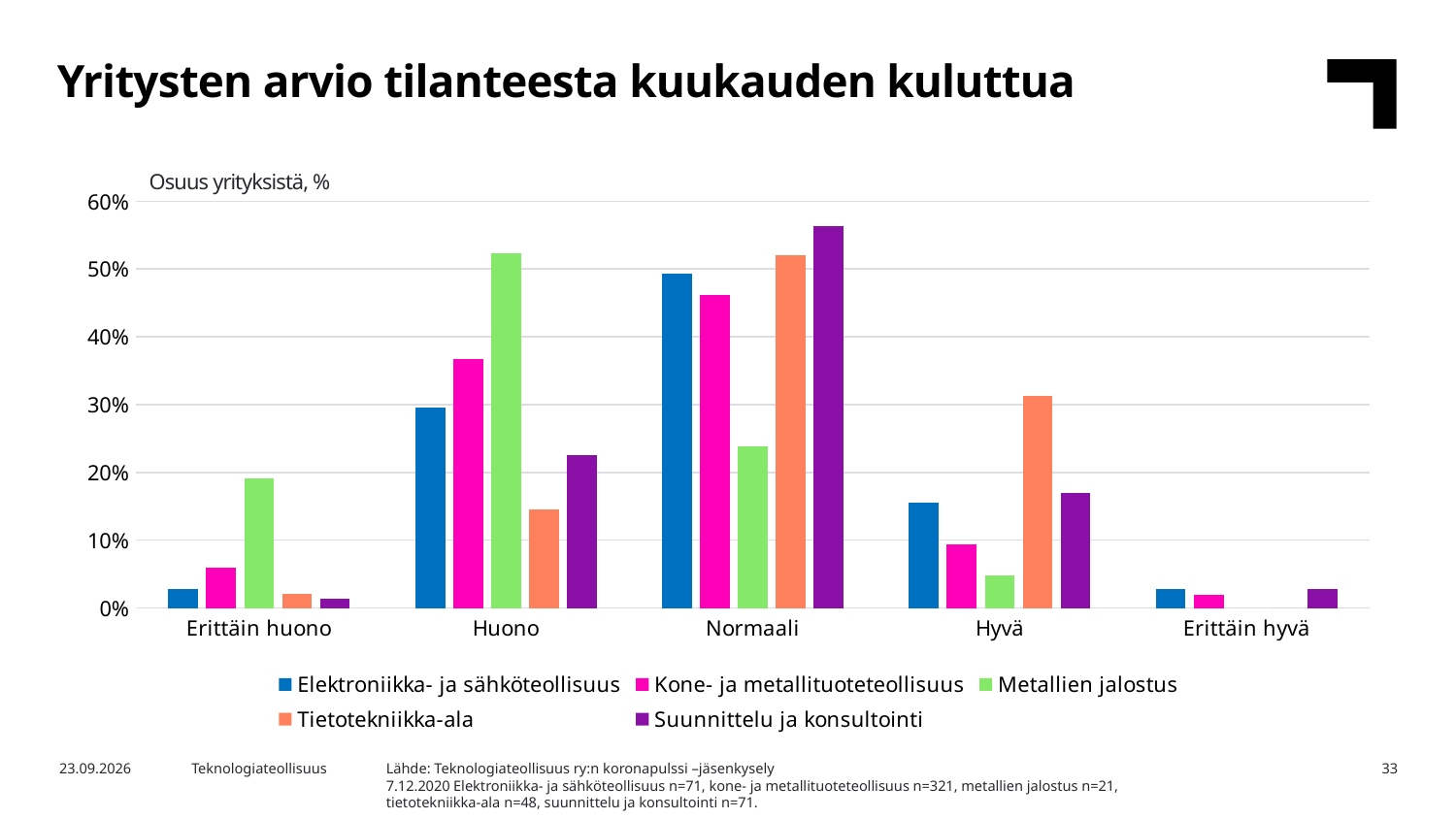
In the Huono category, which is larger: Elektroniikka- ja sähköteollisuus or Kone- ja metallituoteteollisuus? Kone- ja metallituoteteollisuus Is the value for Suunnittelu ja konsultointi in the Normaali category greater or less than 50%? greater In the Hyvä category, which series has the highest value? Tietotekniikka-ala What kind of chart is shown on the slide? bar chart What is the label shown above the y axis? Osuus yrityksistä, % In the Normaali category, which series has the highest value? Suunnittelu ja konsultointi In the Huono category, which series has the lowest value? Tietotekniikka-ala How many categories are shown on the x axis? 5 Is the value for Metallien jalostus in the Huono category greater or less than 50%? greater How many series does the legend list? 5 Is the value for Tietotekniikka-ala in the Hyvä category greater or less than 20%? greater In the Huono category, which series has the highest value? Metallien jalostus